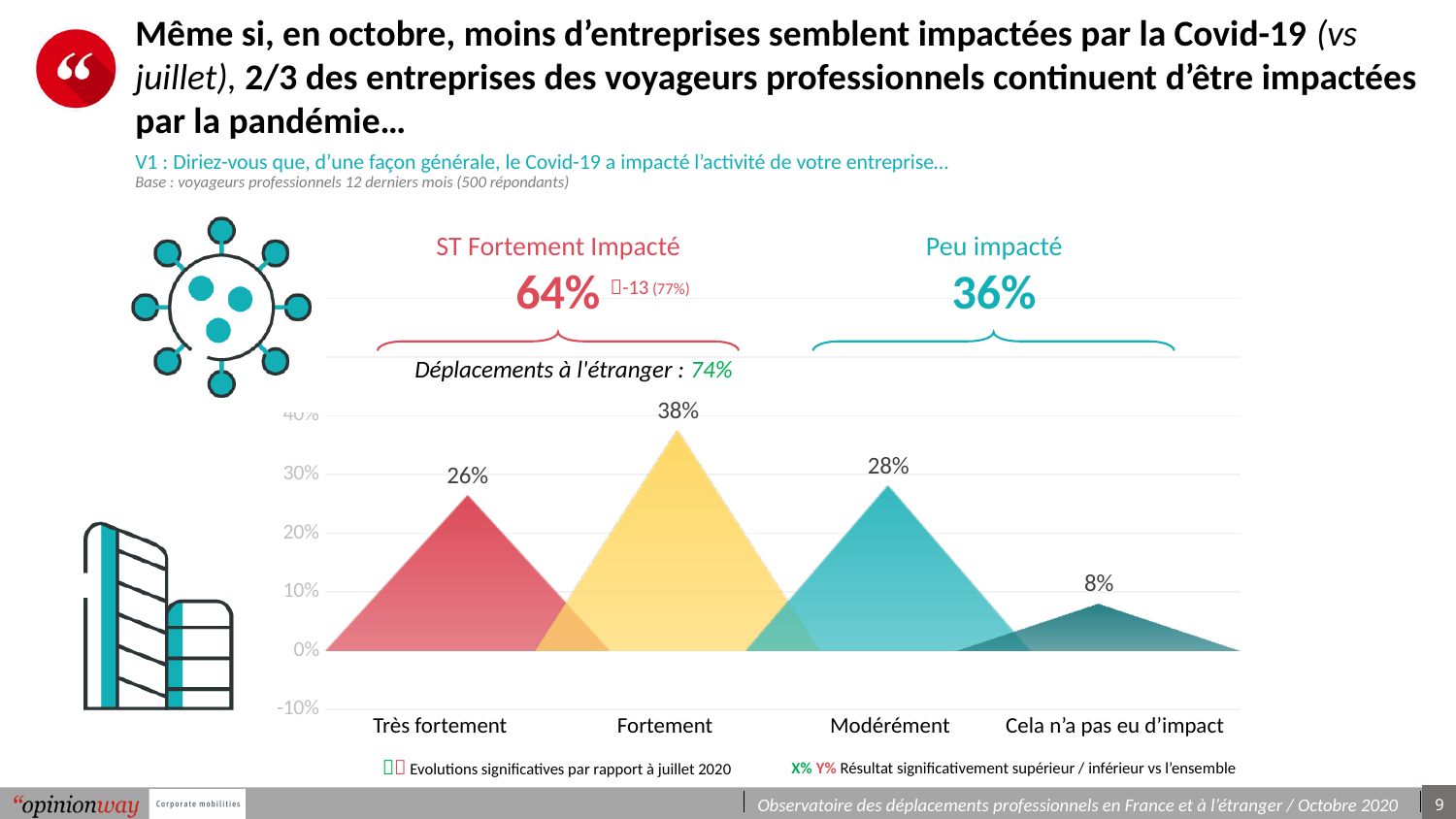
Which is larger, the value for Modérément or the value for Très fortement? Modérément Which category has the highest value? Fortement Is the value for Modérément greater or less than 20%? greater What is the combined value shown for ST Fortement Impacté? 64% Which category has the lowest value? Cela n'a pas eu d'impact What is the value for Très fortement? 26% How many categories are shown on the x axis? 4 What is the value for Fortement? 38% What is the combined value shown for Peu impacté? 36% What is the value for Cela n'a pas eu d'impact? 8% What is the value for Modérément? 28% What is the difference between the values for Fortement and Très fortement? 12%